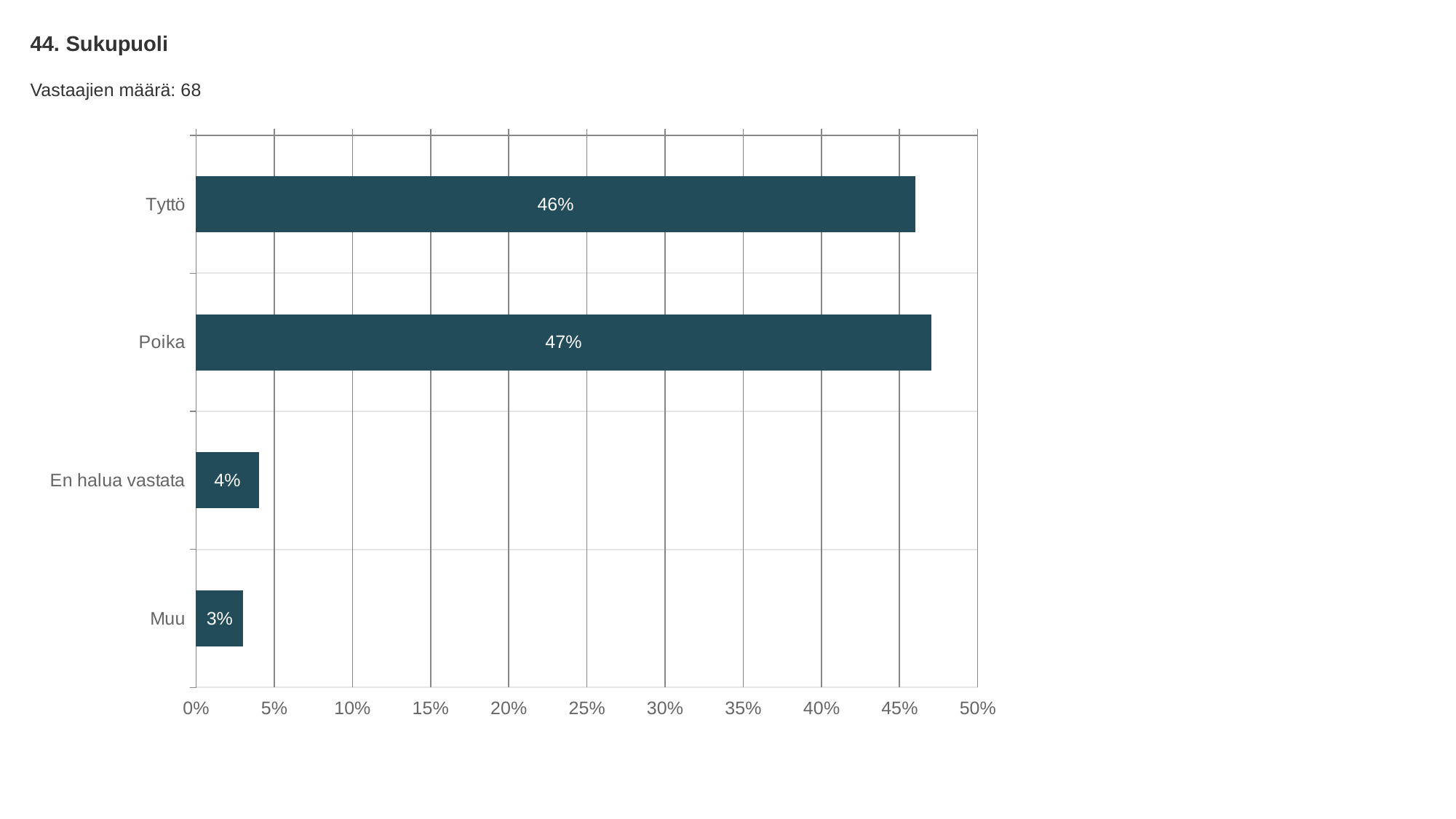
What is the difference between the values for Poika and Tyttö? 1% What is the value for En halua vastata? 4% What is the title of the chart? 44. Sukupuoli How many categories are shown in the chart? 4 Which is larger, the value for En halua vastata or the value for Muu? En halua vastata What is the value for Muu? 3% What kind of chart is shown on the slide? Bar chart Which category has the highest value? Poika Which category has the lowest value? Muu What is the difference between the values for Tyttö and Muu? 43% What is the value for Tyttö? 46% What is the value for Poika? 47%